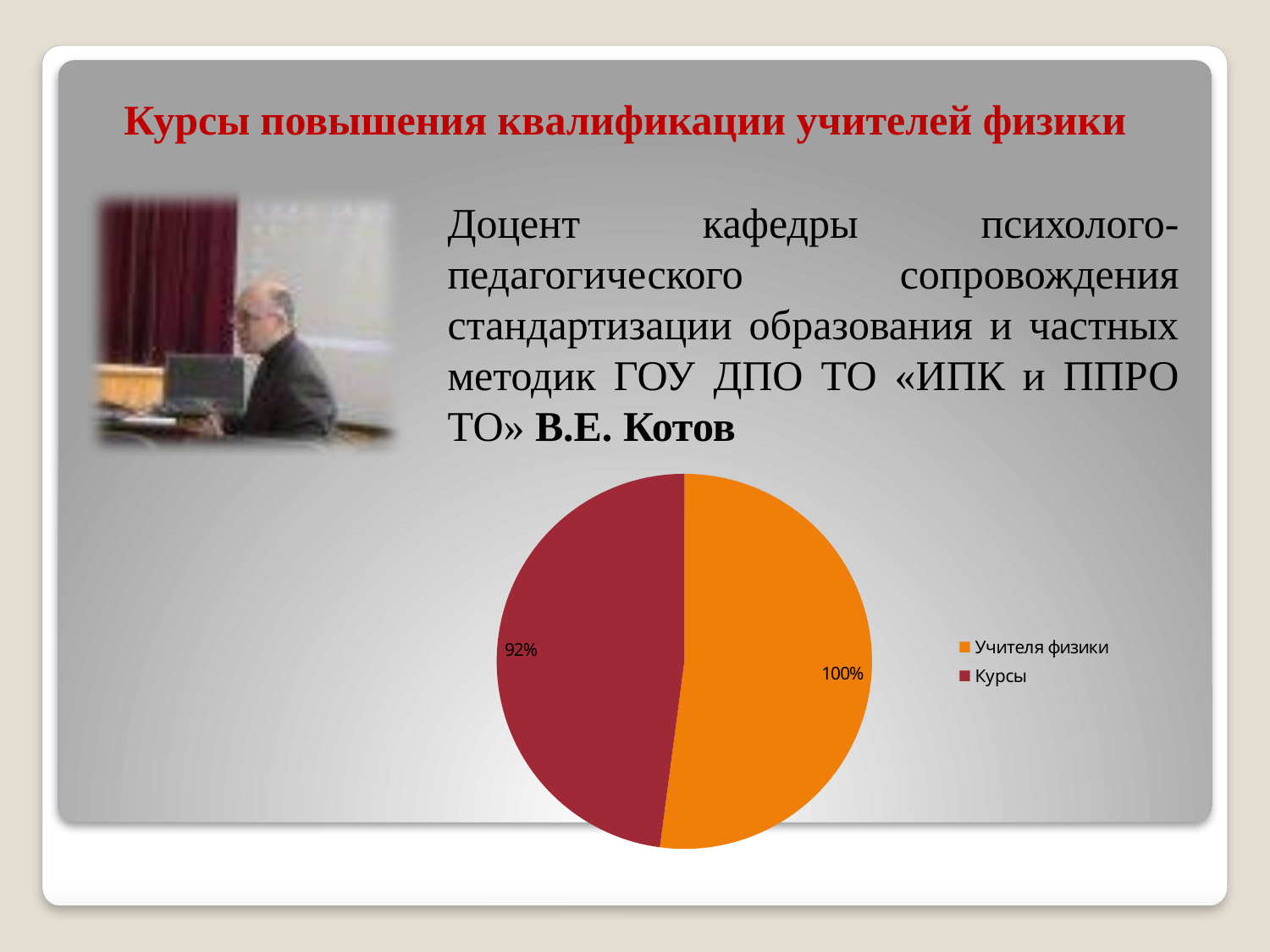
Which slice of the pie chart has the higher labelled value, "Учителя физики" or "Курсы"? Учителя физики What kind of chart is shown on the slide? pie chart Which slice of the pie chart has the lowest labelled value? Курсы What value is labelled on the "Учителя физики" slice of the pie chart? 100% How many entries does the legend of the pie chart list? 2 What colour is the "Учителя физики" slice in the pie chart? orange What is the difference between the labelled values of the "Учителя физики" and "Курсы" slices? 8% How many slices does the pie chart have? 2 Which slice of the pie chart has the highest labelled value? Учителя физики What value is labelled on the "Курсы" slice of the pie chart? 92% What colour is the "Курсы" slice in the pie chart? dark red